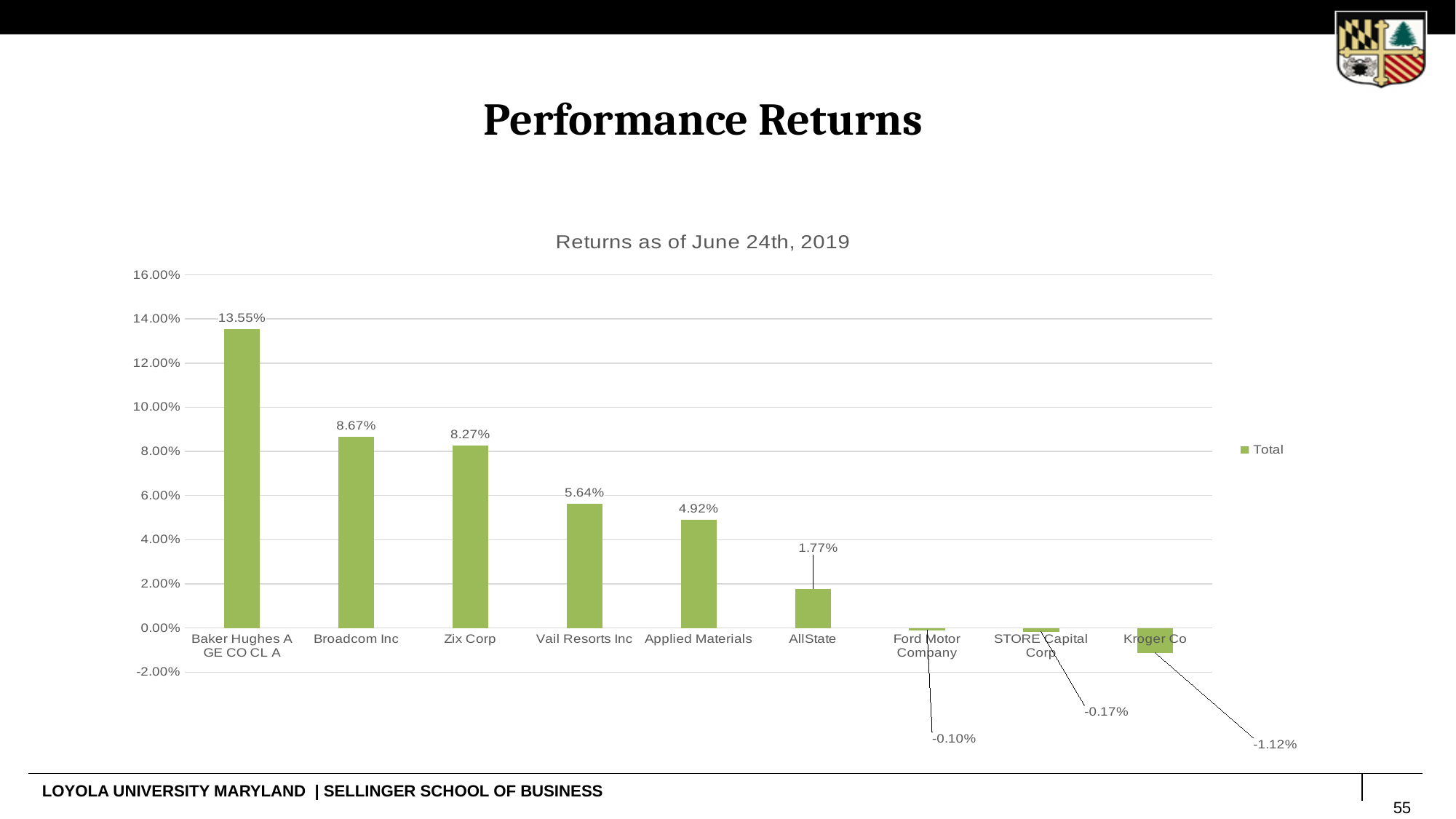
Which company has the lowest return? Kroger Co Which company has the highest return? Baker Hughes A GE CO CL A What is the return for Kroger Co? -1.12% What is the title of the chart? Returns as of June 24th, 2019 What is the return for Zix Corp? 8.27% What type of chart is shown on the slide? Bar chart What is the difference between the returns of Broadcom Inc and Zix Corp? 0.40% What is the return for Ford Motor Company? -0.10% How many companies are shown in the chart? 9 What is the return for Baker Hughes A GE CO CL A? 13.55% Is the return for AllState greater or less than 2.00%? less Which has a higher return, Vail Resorts Inc or Applied Materials? Vail Resorts Inc